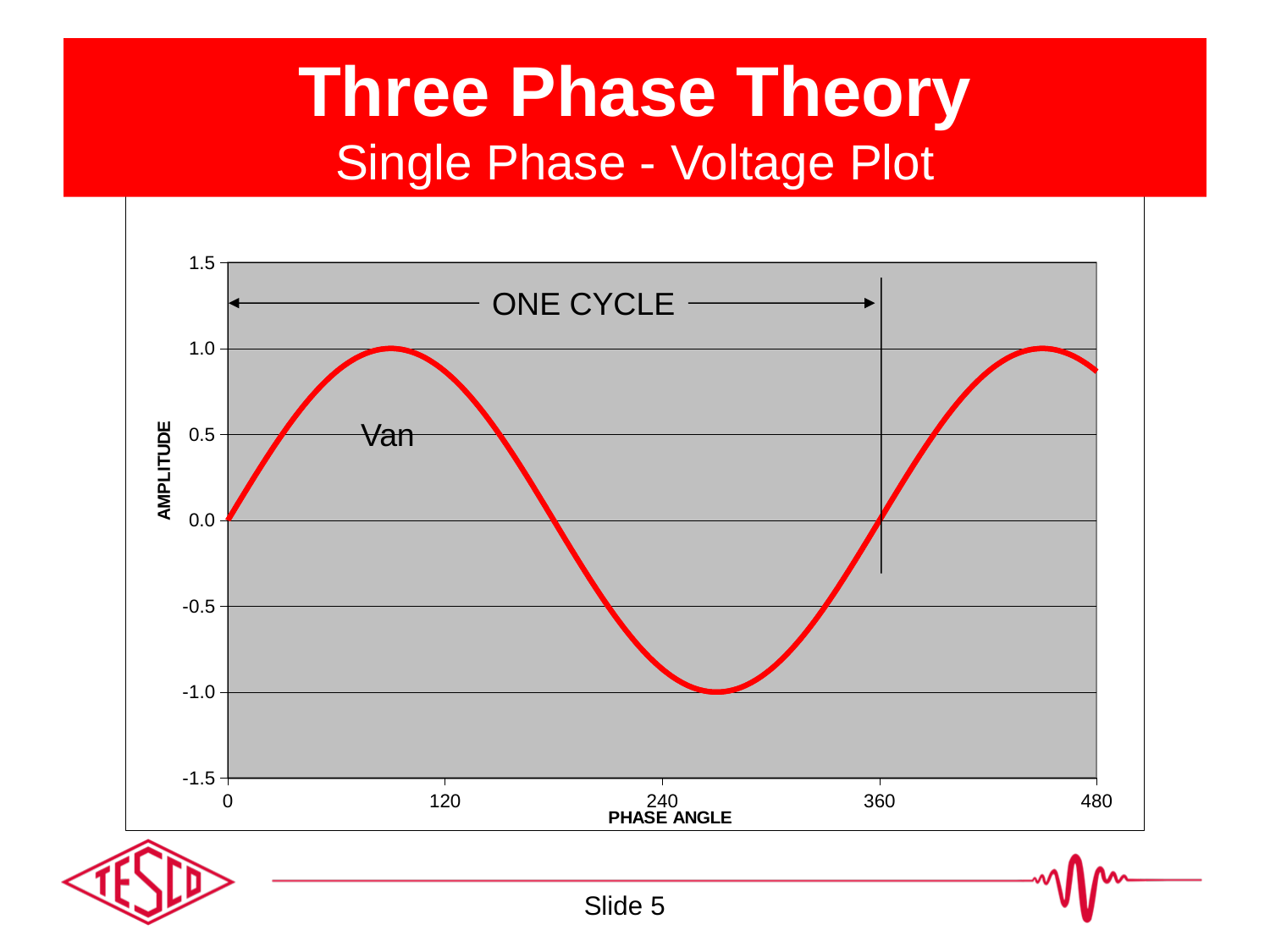
What is the minimum amplitude reached by the Van curve? -1.0 Is the amplitude of Van at a phase angle of 480 greater or less than 0.5? greater What is the amplitude of Van at a phase angle of 0? 0.0 What kind of chart is shown on the slide? line chart What is the maximum amplitude reached by the Van curve? 1.0 Is the amplitude of Van at a phase angle of 240 greater or less than -0.5? less Is the amplitude of Van at a phase angle of 120 greater or less than 0.5? greater Does the Van curve rise or fall between phase angles 120 and 240? fall Does the Van curve rise or fall between phase angles 240 and 360? rise What is the title of the vertical axis of the chart? AMPLITUDE What is the amplitude of Van at a phase angle of 360? 0.0